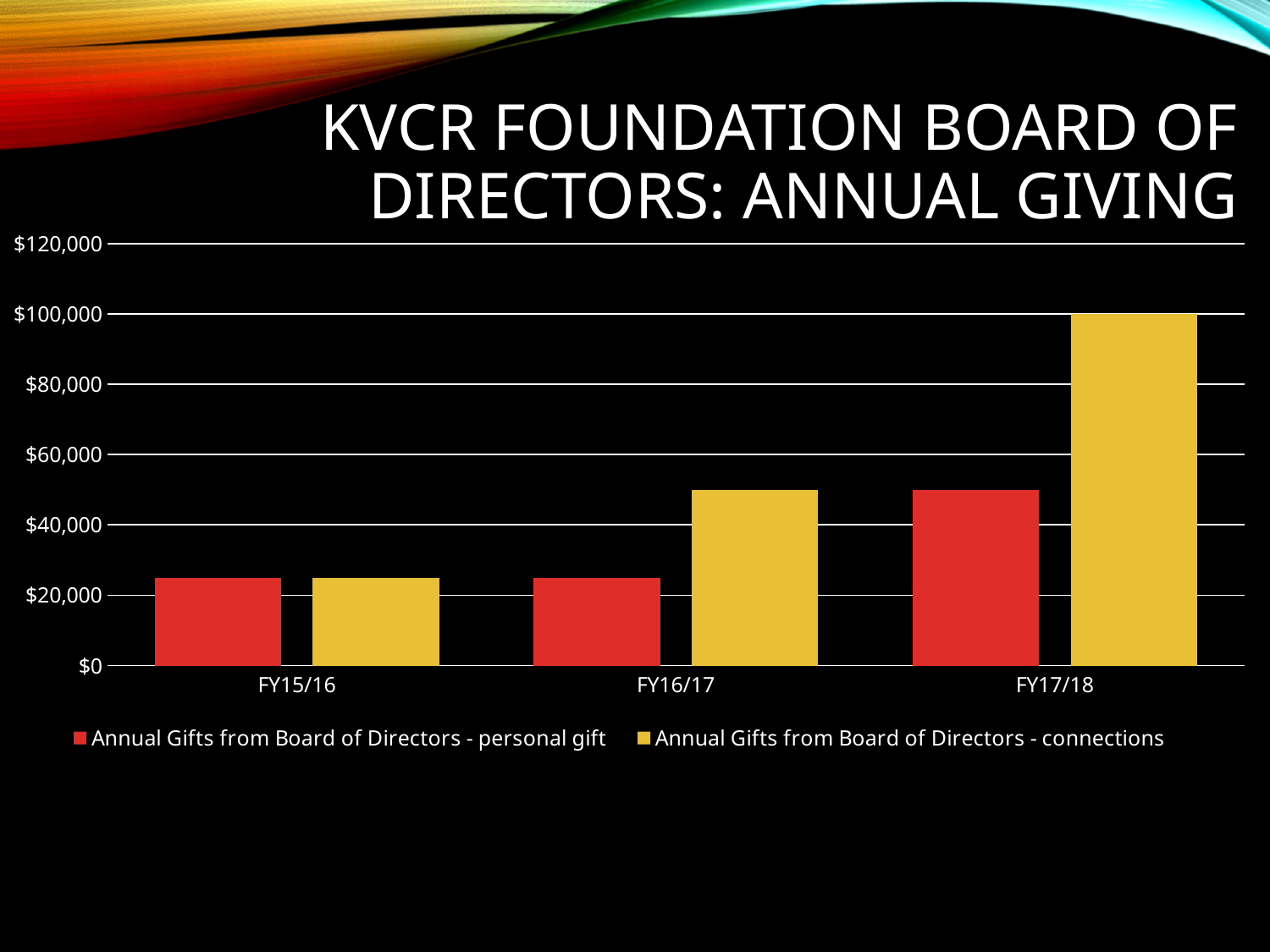
In FY17/18, which is larger: Annual Gifts from Board of Directors - personal gift or Annual Gifts from Board of Directors - connections? Annual Gifts from Board of Directors - connections Which fiscal year has the highest value for Annual Gifts from Board of Directors - connections? FY17/18 What is the value of Annual Gifts from Board of Directors - connections for FY17/18? $100,000 What kind of chart is shown on the slide? bar chart Is the value for Annual Gifts from Board of Directors - connections in FY16/17 greater or less than $40,000? greater How many fiscal years are shown on the x axis? 3 What colour are the bars for Annual Gifts from Board of Directors - personal gift? red Is the value for Annual Gifts from Board of Directors - personal gift in FY17/18 greater or less than $60,000? less How many series does the legend list? 2 Is the value for Annual Gifts from Board of Directors - personal gift in FY15/16 greater or less than $40,000? less Do the values for Annual Gifts from Board of Directors - connections rise or fall from FY15/16 to FY17/18? rise Which fiscal year has the highest value for Annual Gifts from Board of Directors - personal gift? FY17/18